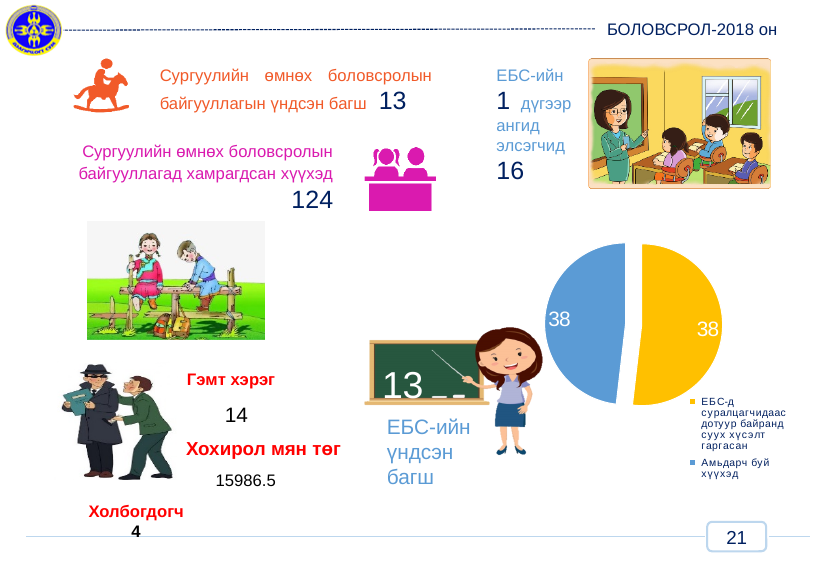
Which colour is used for the "Амьдарч буй хүүхэд" slice in the pie chart? Blue How many entries does the pie chart's legend list? 2 What is the value of the slice labelled "ЕБС-д суралцагчидаас дотуур байранд суух хүсэлт гаргасан" in the pie chart? 38 What kind of chart is shown on the slide? Pie chart What is the total of the two slices in the pie chart? 76 What is the difference between the "ЕБС-д суралцагчидаас дотуур байранд суух хүсэлт гаргасан" slice and the "Амьдарч буй хүүхэд" slice in the pie chart? 0 What is the value of the slice labelled "Амьдарч буй хүүхэд" in the pie chart? 38 Which colour is used for the "ЕБС-д суралцагчидаас дотуур байранд суух хүсэлт гаргасан" slice in the pie chart? Yellow How many slices does the pie chart have? 2